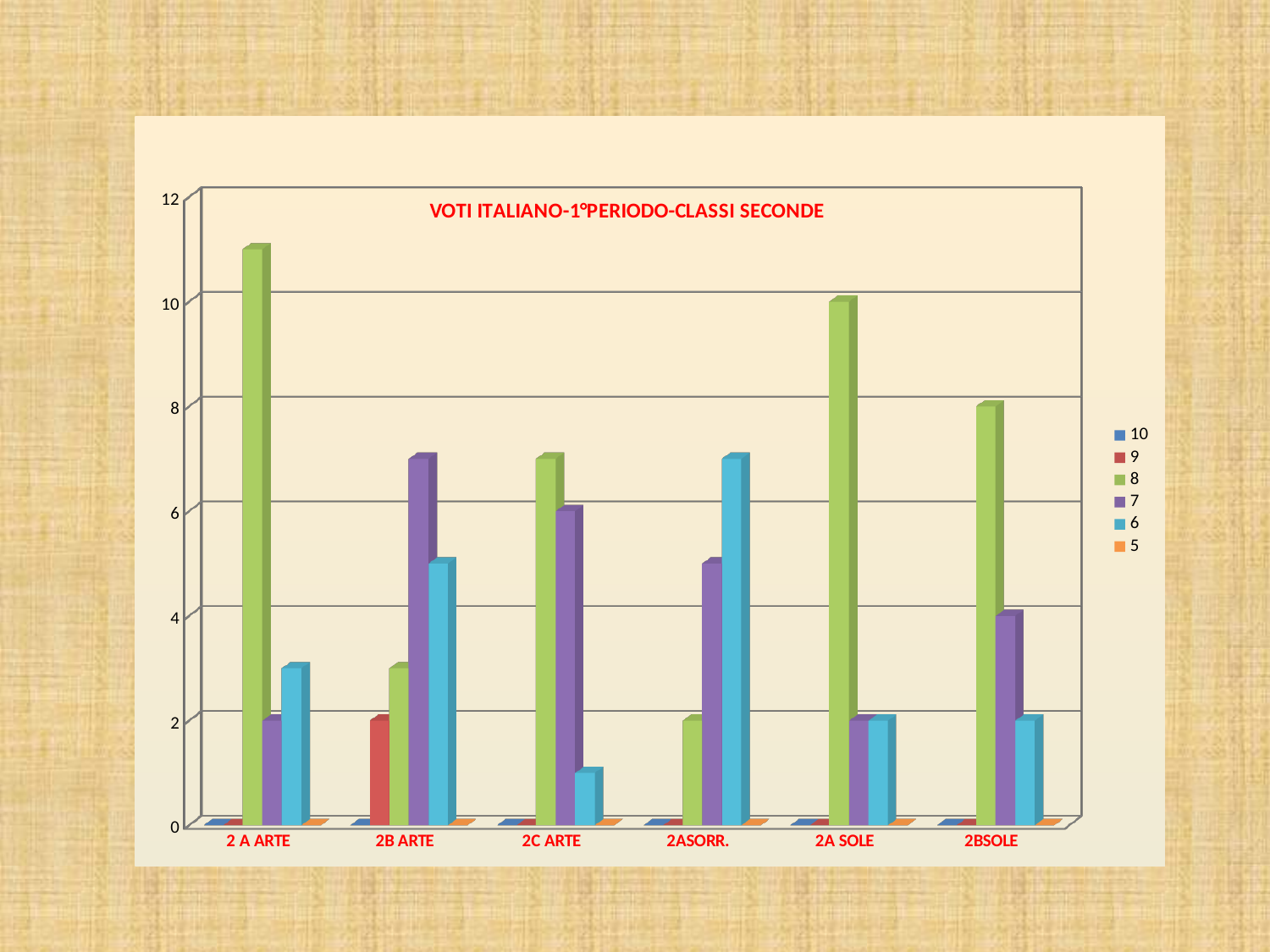
In 2ASORR., which series has the larger value, '6' or '7'? 6 Is the value for series '6' in 2C ARTE greater or less than 2? less Is the value for series '7' in 2B ARTE greater or less than 6? greater Is the value for series '7' in 2BSOLE greater or less than 6? less Which class has the tallest bar for the series '8'? 2 A ARTE How many series does the legend list? 6 What is the title of the chart? VOTI ITALIANO-1°PERIODO-CLASSI SECONDE In 2C ARTE, which series has the larger value, '8' or '6'? 8 What is the value for series '8' in 2A SOLE? 10 What kind of chart is shown on the slide? bar chart How many classes (categories) are shown on the x axis of the chart? 6